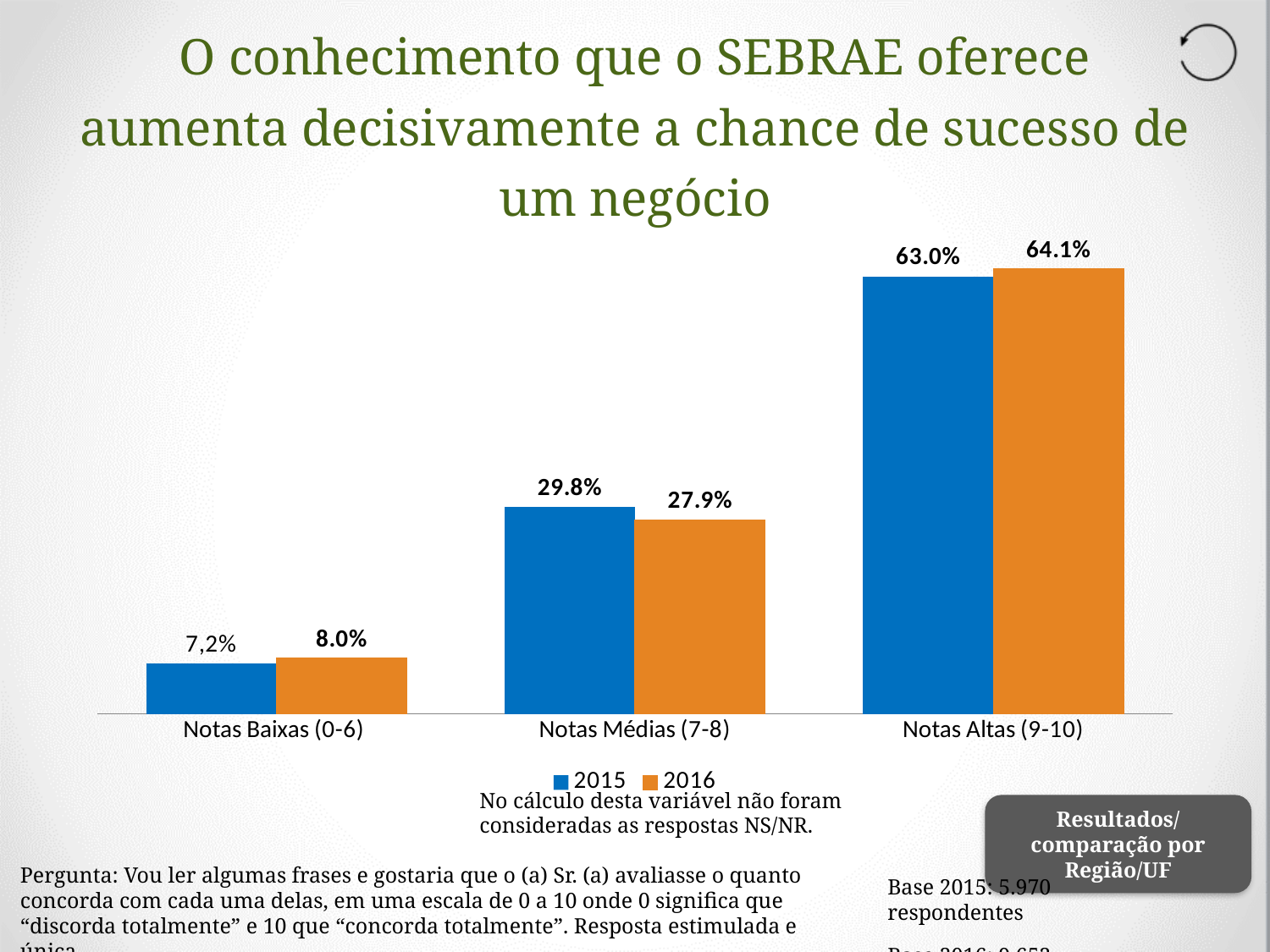
What kind of chart is shown on the slide? Bar chart How many categories are shown on the x axis? 3 What is the value for 2015 in the Notas Altas (9-10) category? 63.0% Which category has the highest value for the 2016 series? Notas Altas (9-10) What is the value for 2016 in the Notas Baixas (0-6) category? 8.0% How many series does the legend list? 2 What is the difference between the 2016 and 2015 values in the Notas Altas (9-10) category? 1.1 percentage points What is the value for 2016 in the Notas Médias (7-8) category? 27.9% In the Notas Médias (7-8) category, which series has the larger value, 2015 or 2016? 2015 Which category has the lowest value for the 2015 series? Notas Baixas (0-6) What is the difference between the 2015 and 2016 values in the Notas Médias (7-8) category? 1.9 percentage points What is the value for 2015 in the Notas Baixas (0-6) category? 7,2%